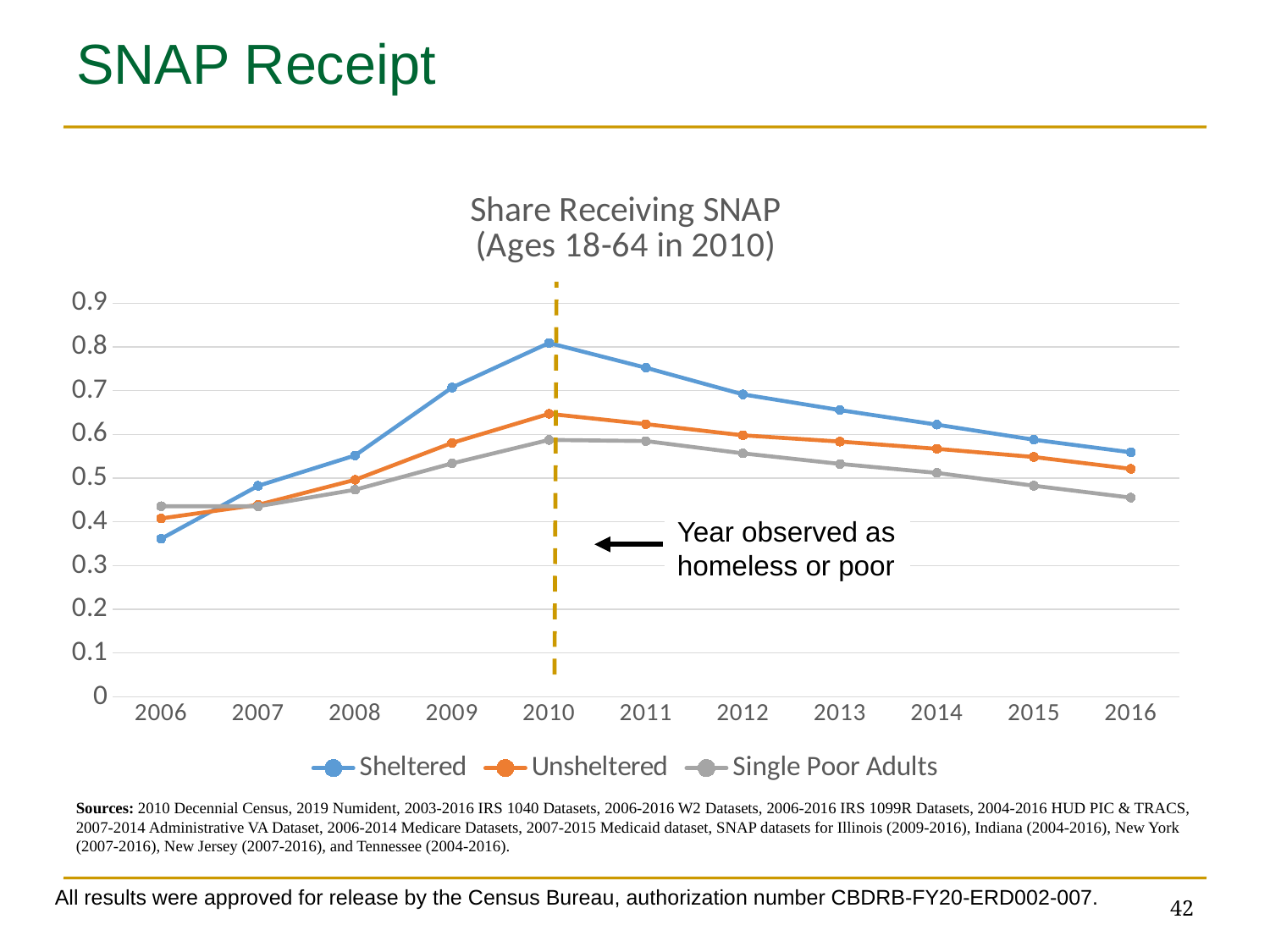
Is the Single Poor Adults value in 2016 greater or less than 0.5? less Which series has the highest value in 2010? Sheltered What kind of chart is shown on the slide? line chart In which year is the Sheltered series at its lowest value? 2006 How many series does the legend list? 3 Does the Sheltered series rise or fall from 2010 to 2016? fall What is the title of the chart? Share Receiving SNAP (Ages 18-64 in 2010) Which series has the lowest value in 2016? Single Poor Adults How many years are shown on the x axis? 11 In which year does the Sheltered series reach its highest value? 2010 In 2006, which is larger, the Sheltered value or the Unsheltered value? Unsheltered Is the Sheltered value in 2010 greater or less than 0.7? greater